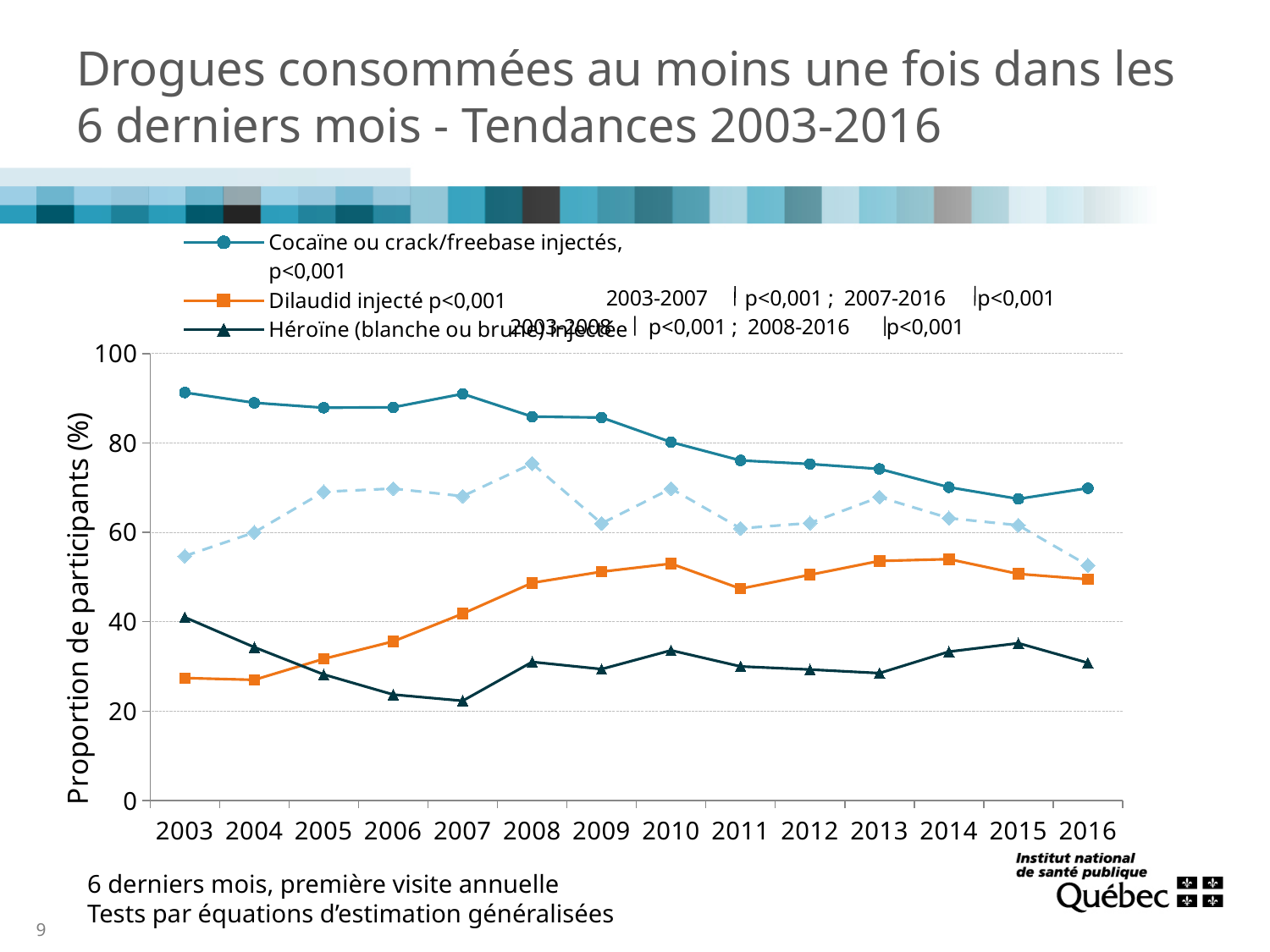
How many series does the legend list? 3 Does the Cocaïne ou crack/freebase injectés series rise or fall overall from 2003 to 2016? fall Is the value for Dilaudid injecté in 2003 greater or less than 40? less How many years are plotted along the x axis? 14 What kind of chart is shown on the slide? line chart Is the value for Cocaïne ou crack/freebase injectés in 2003 greater or less than 80? greater In which year is the Héroïne (blanche ou brune) injectée series at its highest? 2003 In 2016, which is larger: Dilaudid injecté or Héroïne (blanche ou brune) injectée? Dilaudid injecté Is the value for Dilaudid injecté in 2014 greater or less than 60? less Does the Dilaudid injecté series rise or fall overall from 2003 to 2016? rise